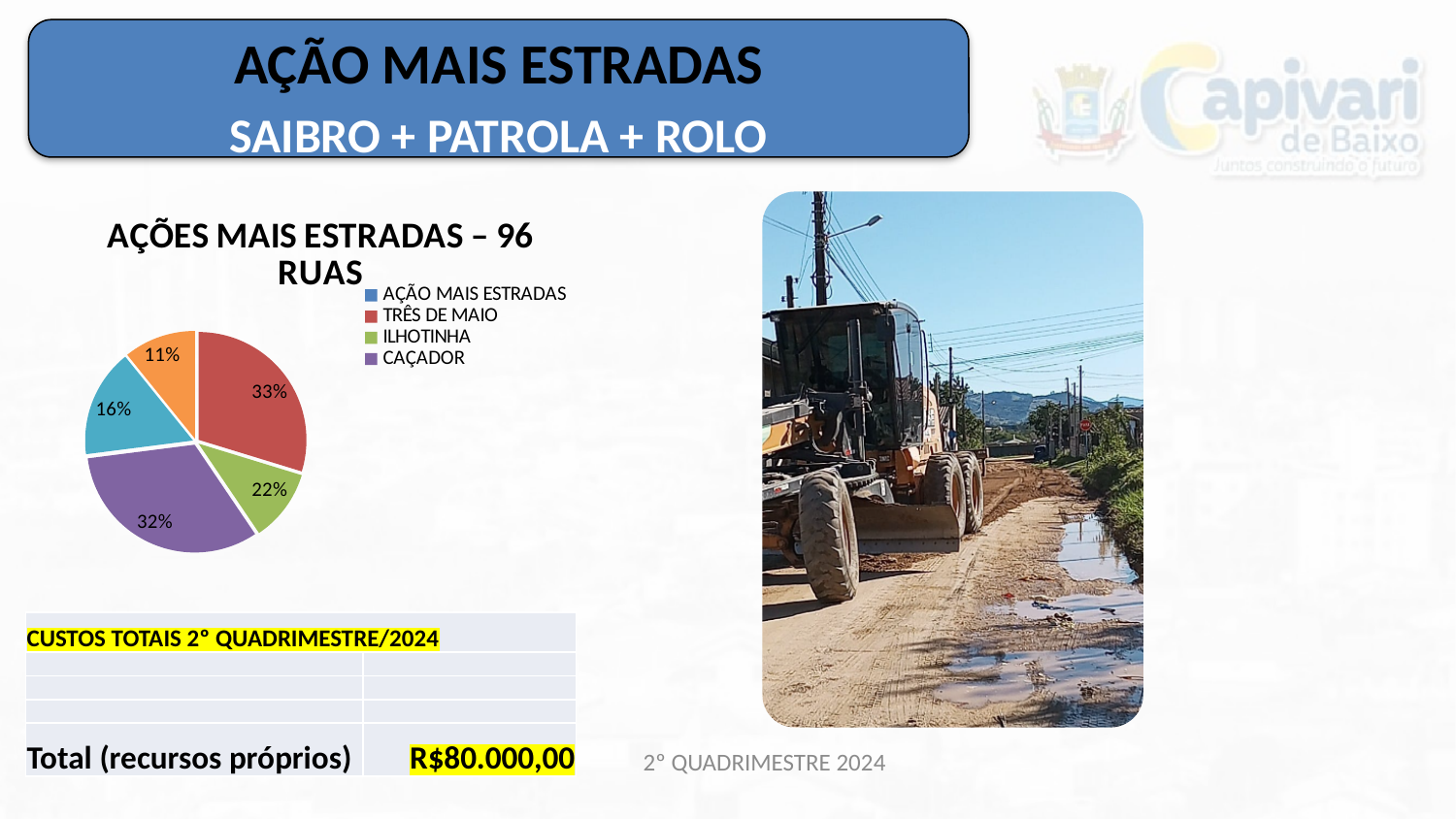
What is the smallest percentage shown on the pie chart? 11% What percentage of the pie chart does TRÊS DE MAIO represent? 33% Which has a larger share of the pie chart, CAÇADOR or ILHOTINHA? CAÇADOR How many entries does the chart legend list? 4 What is the title of the chart? AÇÕES MAIS ESTRADAS – 96 RUAS Which legend category has the largest share of the pie chart? TRÊS DE MAIO What percentage of the pie chart does CAÇADOR represent? 32% What is the difference in percentage points between TRÊS DE MAIO and ILHOTINHA? 11 percentage points How many slices does the pie chart have? 5 What colour represents CAÇADOR in the pie chart? Purple What type of chart is shown on the slide? Pie chart What percentage of the pie chart does ILHOTINHA represent? 22%